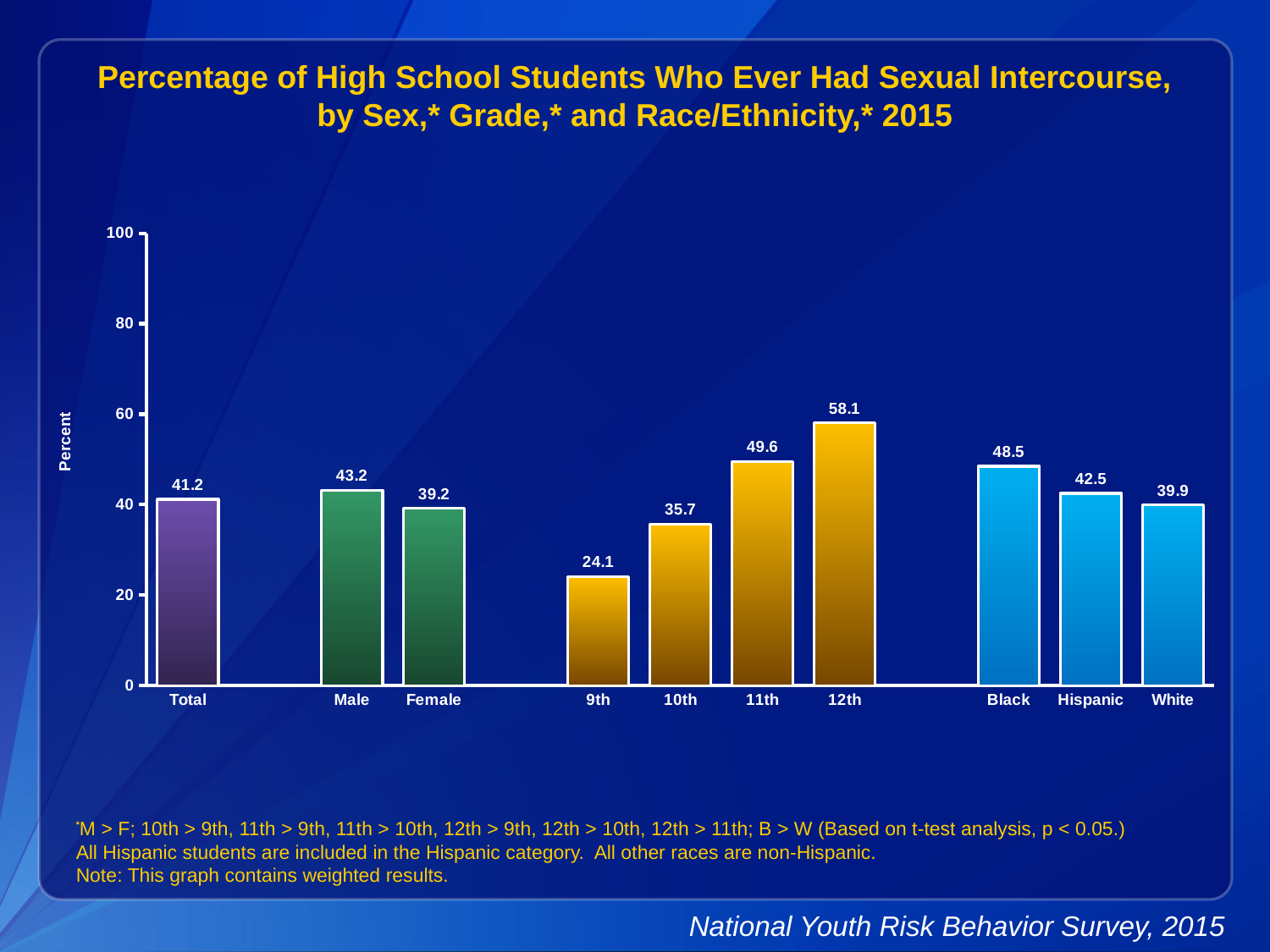
What is the value for Total? 41.2 Which category has the lowest value? 9th What is the difference between the values for Male and Female? 4.0 What is the value for Hispanic students? 42.5 Which is larger, the value for 11th grade or the value for Black? 11th What is the value for 12th grade students? 58.1 What is the difference between the values for Black and White? 8.6 What kind of chart is shown on the slide? bar chart Do the values rise or fall from 9th grade to 12th grade? rise Is the value for 10th grade greater or less than 40? less How many bars are shown in the chart? 10 Which category has the highest value? 12th